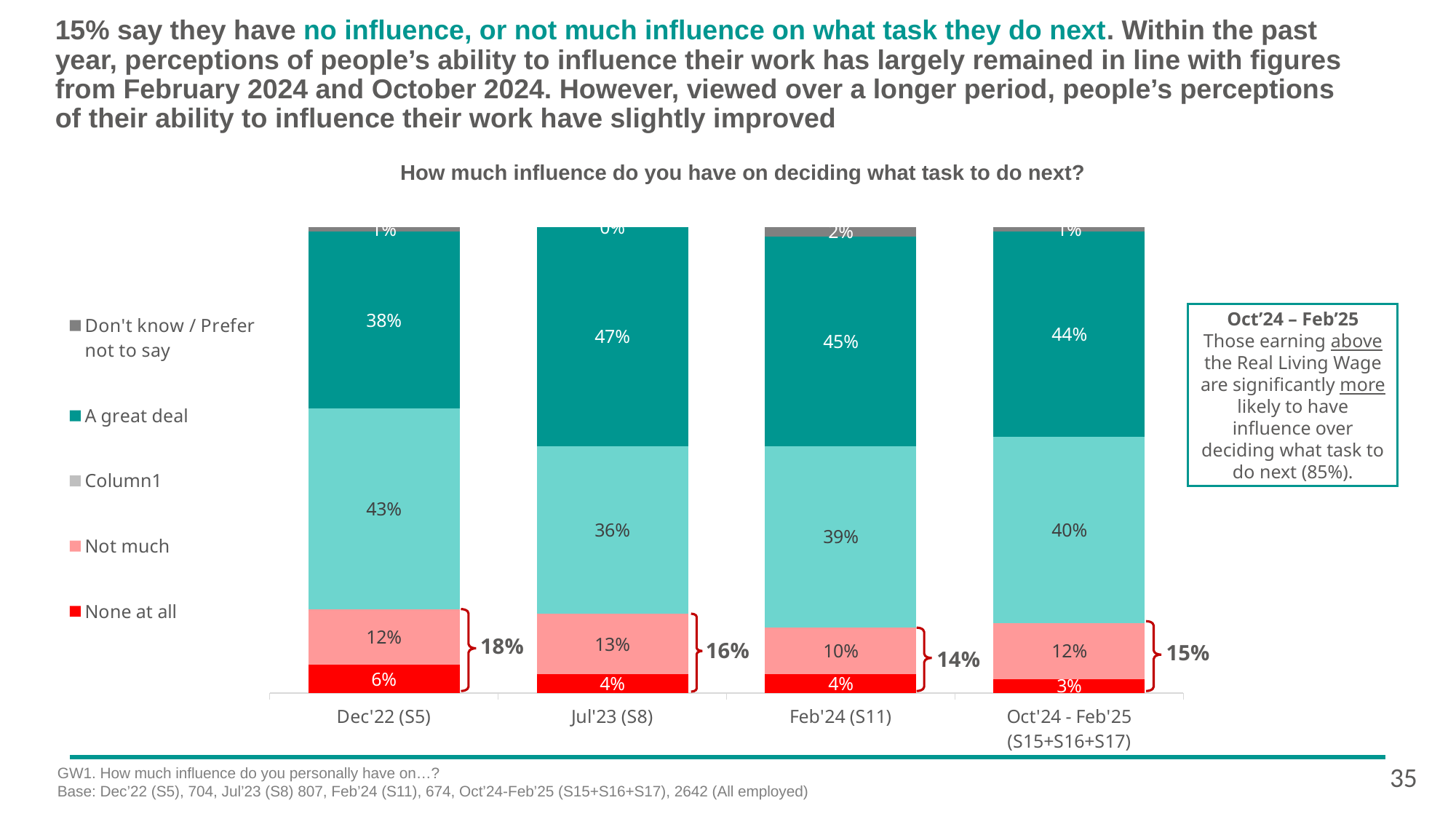
How many series does the chart legend list? 5 What is the title of the chart? How much influence do you have on deciding what task to do next? What is the 'A great deal' value for Jul'23 (S8)? 47% What is the combined 'None at all' and 'Not much' figure shown by the bracket for Oct'24 - Feb'25 (S15+S16+S17)? 15% Which period has the highest 'A great deal' value? Jul'23 (S8) Which is larger: the 'Not much' value for Jul'23 (S8) or for Feb'24 (S11)? Jul'23 (S8) What is the difference between the 'A great deal' values for Jul'23 (S8) and Dec'22 (S5)? 9 percentage points What type of chart is shown on the slide? Stacked bar chart Which period has the lowest 'None at all' value? Oct'24 - Feb'25 (S15+S16+S17) What is the 'None at all' value for Dec'22 (S5)? 6% How many time periods (bars) are shown on the x axis of the chart? 4 What is the 'Not much' value for Feb'24 (S11)? 10%